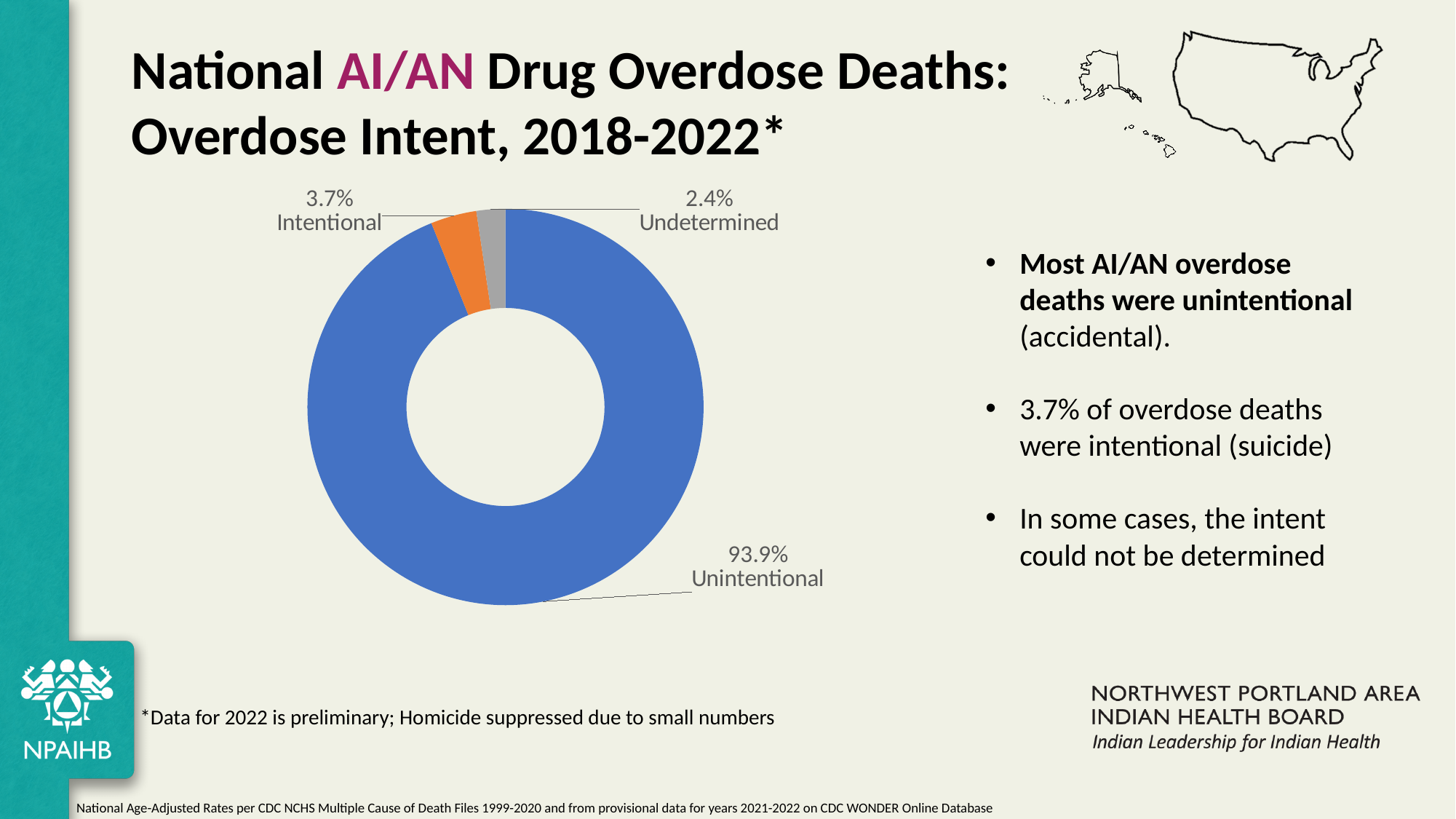
Which is larger, the Intentional share or the Undetermined share? Intentional What colour is the Intentional slice of the chart? Orange What percentage of AI/AN drug overdose deaths were Intentional? 3.7% Which overdose intent category has the smallest share of the chart? Undetermined What percentage of AI/AN drug overdose deaths were Undetermined? 2.4% What percentage of AI/AN drug overdose deaths were Unintentional? 93.9% What colour is the Unintentional slice of the chart? Blue What is the difference in percentage points between the Intentional and Undetermined shares? 1.3 What is the difference in percentage points between the Unintentional and Intentional shares? 90.2 Which overdose intent category has the largest share of the chart? Unintentional How many overdose intent categories are shown in the chart? 3 What kind of chart is shown on the slide? Doughnut (pie) chart